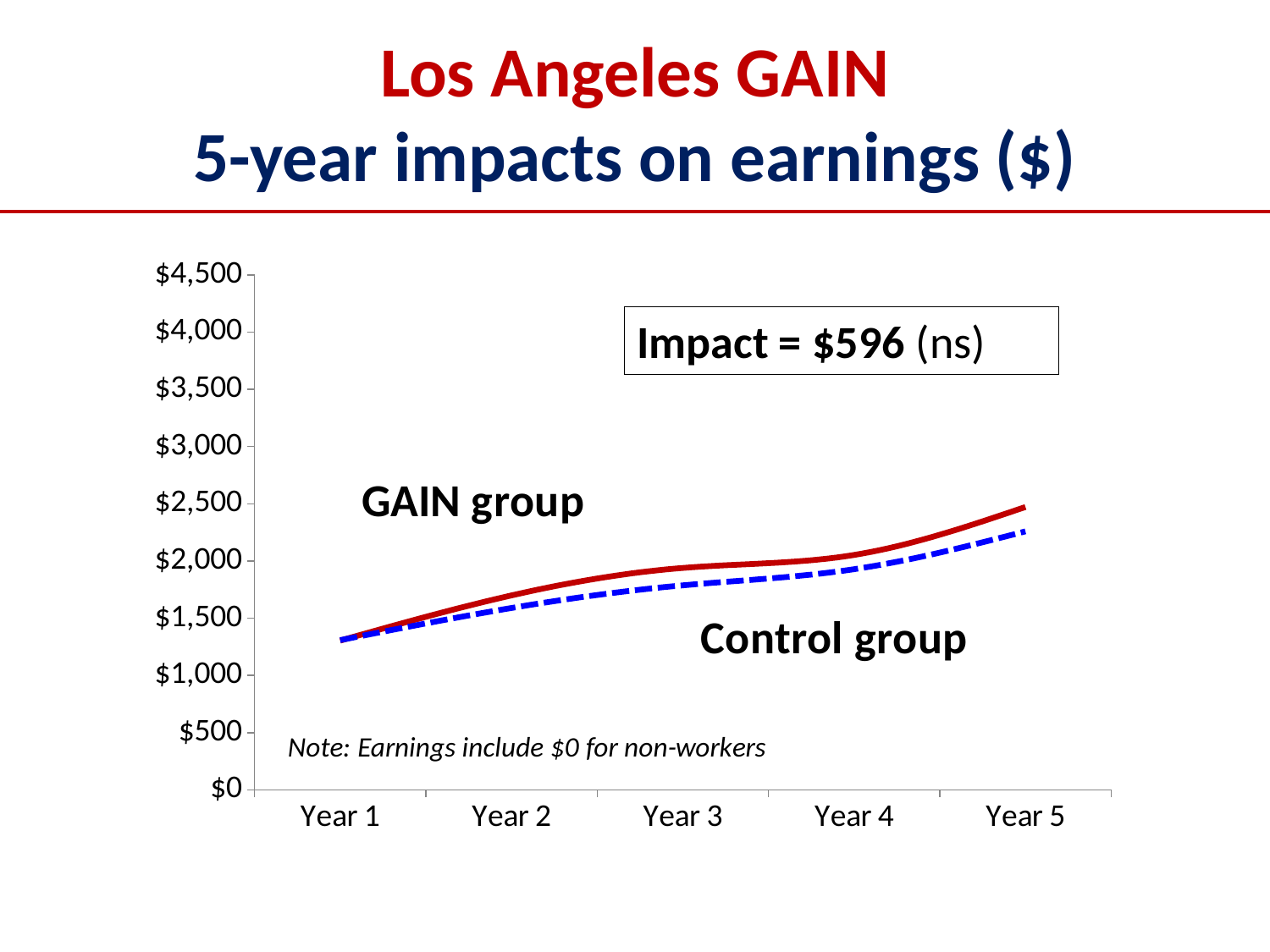
Do the earnings of the GAIN group rise or fall from Year 1 to Year 5? Rise Do the earnings of the Control group rise or fall from Year 1 to Year 5? Rise How many groups (series) are plotted on the chart? 2 Is the value for the Control group in Year 5 greater or less than $3,000? less How many years are shown along the x axis of the chart? 5 What impact on earnings is stated in the box on the chart? $596 (ns) In Year 5, which group has higher earnings, the GAIN group or the Control group? GAIN group Is the value for the Control group in Year 1 greater or less than $1,500? less Which group is drawn with a dashed line on the chart? Control group Is the value for the GAIN group in Year 5 greater or less than $2,000? greater What kind of chart is shown on the slide? Line chart